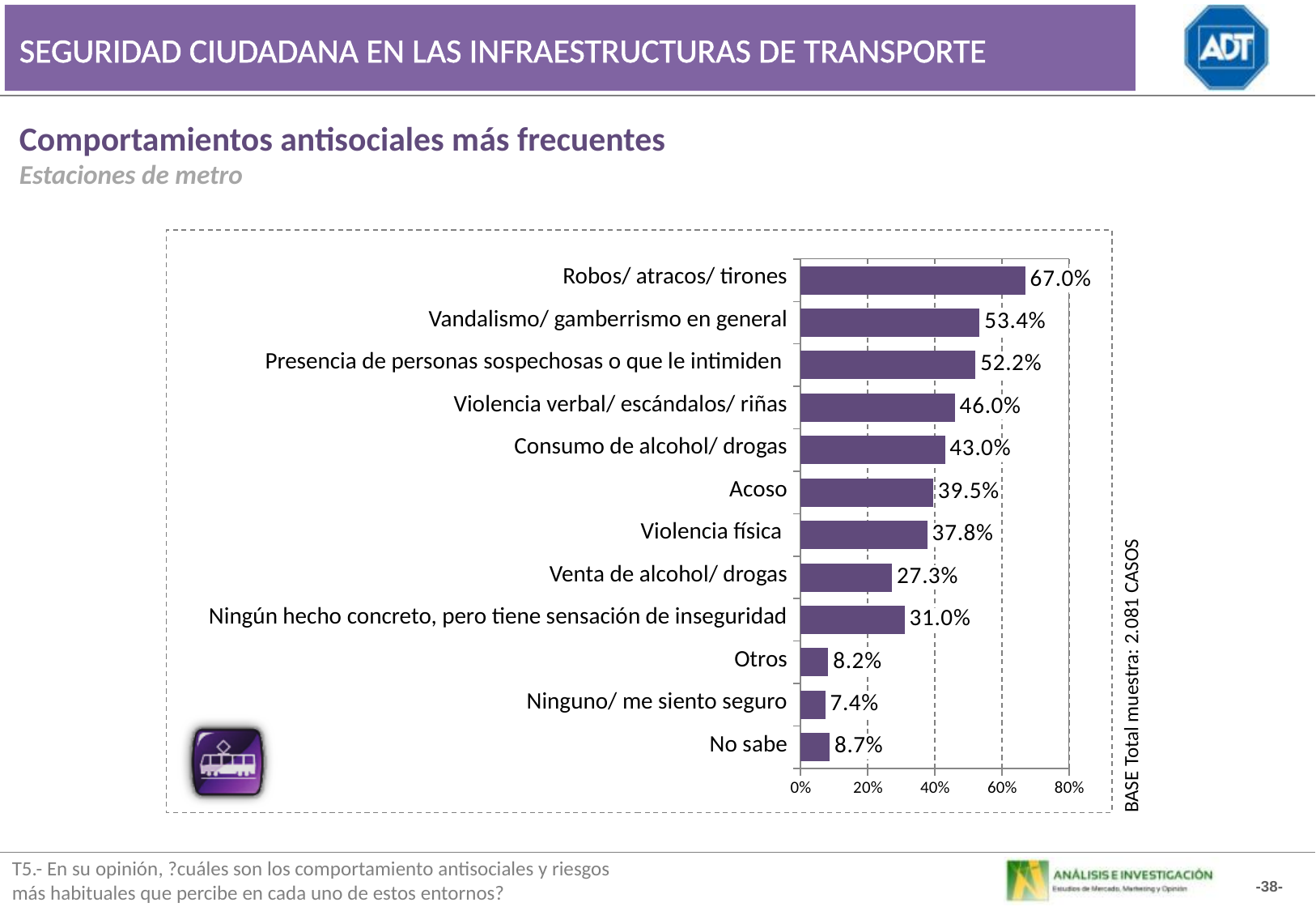
What is the difference between Robos/ atracos/ tirones and Violencia física? 29.2% What is the value for Acoso? 39.5% Is the value for Consumo de alcohol/ drogas greater or less than 40%? greater Which category has the lowest value? Ninguno/ me siento seguro What is the base (total sample) stated next to the chart? 2.081 CASOS What is the value for Ninguno/ me siento seguro? 7.4% How many categories are shown in the chart? 12 What is the value for Robos/ atracos/ tirones? 67.0% What is the difference between Vandalismo/ gamberrismo en general and Presencia de personas sospechosas o que le intimiden? 1.2% What kind of chart is shown on the slide? bar chart Which category has the highest value? Robos/ atracos/ tirones Which is larger: Venta de alcohol/ drogas or Ningún hecho concreto, pero tiene sensación de inseguridad? Ningún hecho concreto, pero tiene sensación de inseguridad